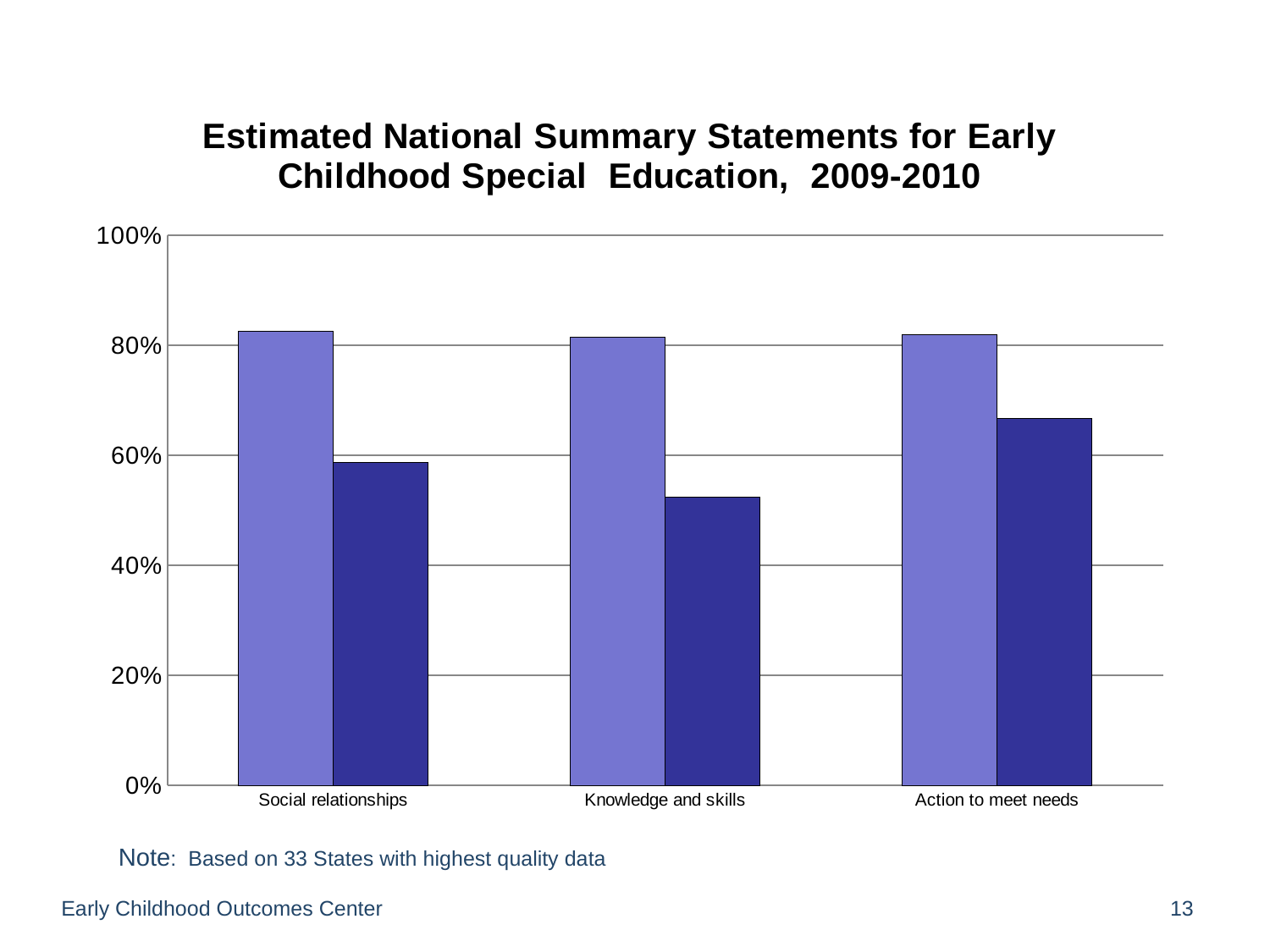
For Social relationships, which bar is larger, the light purple bar or the dark blue bar? the light purple bar Among the dark blue bars, which category has the highest value? Action to meet needs Among the dark blue bars, which category has the lowest value? Knowledge and skills Is the value of the dark blue bar for Action to meet needs greater or less than 60%? greater Is the value of the dark blue bar for Knowledge and skills greater or less than 60%? less How many categories are shown on the x axis? 3 Is the value of the light purple bar for Knowledge and skills greater or less than 60%? greater What is the title of the chart? Estimated National Summary Statements for Early Childhood Special Education, 2009-2010 Which is larger: the dark blue bar for Action to meet needs or the dark blue bar for Knowledge and skills? Action to meet needs What kind of chart is shown on the slide? bar chart